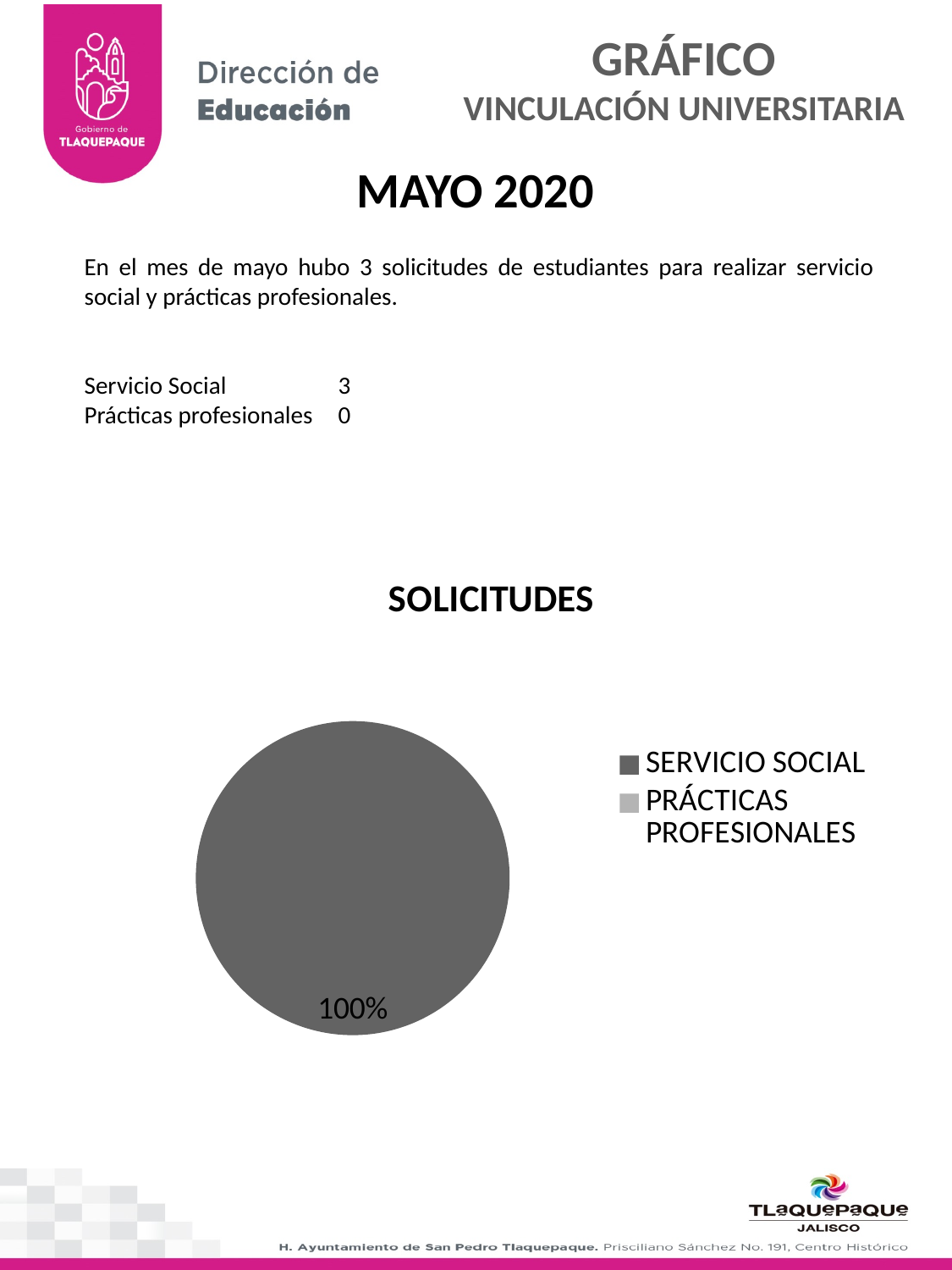
Which category has the smallest share in the SOLICITUDES pie chart? PRÁCTICAS PROFESIONALES In the SOLICITUDES pie chart, which is larger: SERVICIO SOCIAL or PRÁCTICAS PROFESIONALES? SERVICIO SOCIAL What share of the SOLICITUDES pie does SERVICIO SOCIAL account for? 100% How many entries does the legend of the SOLICITUDES pie chart list? 2 What kind of chart is shown under the title SOLICITUDES? pie chart Which category has the largest slice in the SOLICITUDES pie chart? SERVICIO SOCIAL Which legend entry of the SOLICITUDES chart is shown in dark grey? SERVICIO SOCIAL How many slices are visible in the SOLICITUDES pie chart? 1 What is the title of the chart on the slide? SOLICITUDES What percentage label is printed on the SOLICITUDES pie chart? 100%